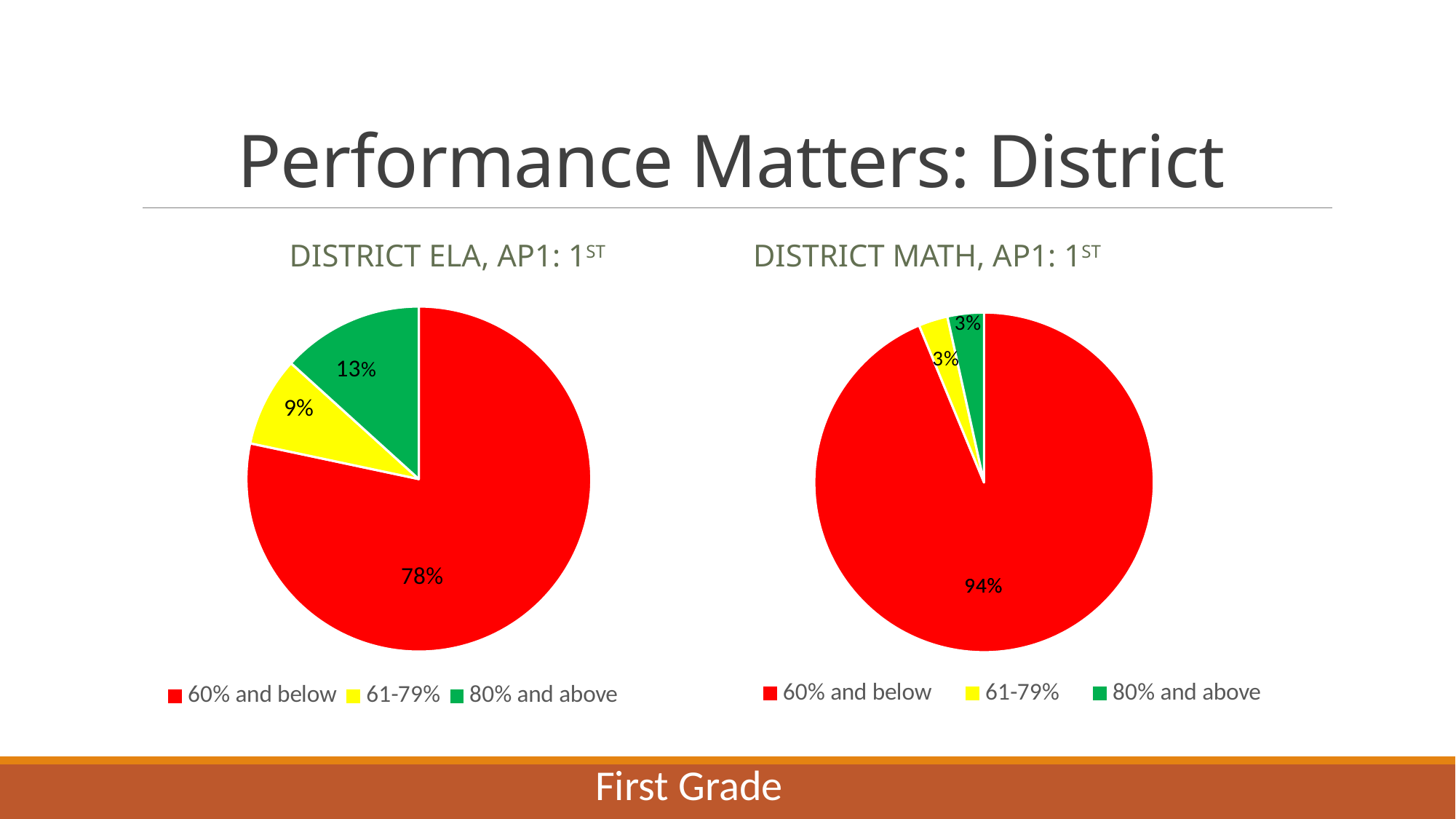
What kind of chart is the DISTRICT ELA, AP1: 1ST chart? Pie chart In the DISTRICT ELA, AP1: 1ST chart, what is the value for '61-79%'? 9% In the DISTRICT MATH, AP1: 1ST chart, which category has the largest slice? 60% and below In the DISTRICT ELA, AP1: 1ST chart, what share of the pie is '60% and below'? 78% In the DISTRICT ELA, AP1: 1ST chart, what is the value for '80% and above'? 13% Which chart has the larger '60% and below' slice, DISTRICT ELA, AP1: 1ST or DISTRICT MATH, AP1: 1ST? DISTRICT MATH, AP1: 1ST In the DISTRICT ELA, AP1: 1ST chart, what colour is the '80% and above' slice? Green In the DISTRICT ELA, AP1: 1ST chart, what is the difference between the '80% and above' and '61-79%' slices? 4% In the DISTRICT ELA, AP1: 1ST chart, which category has the smallest slice? 61-79% In the DISTRICT MATH, AP1: 1ST chart, what share of the pie is '60% and below'? 94% In the DISTRICT MATH, AP1: 1ST chart, what is the value for '80% and above'? 3% How many categories does the legend of the DISTRICT MATH, AP1: 1ST chart list? 3